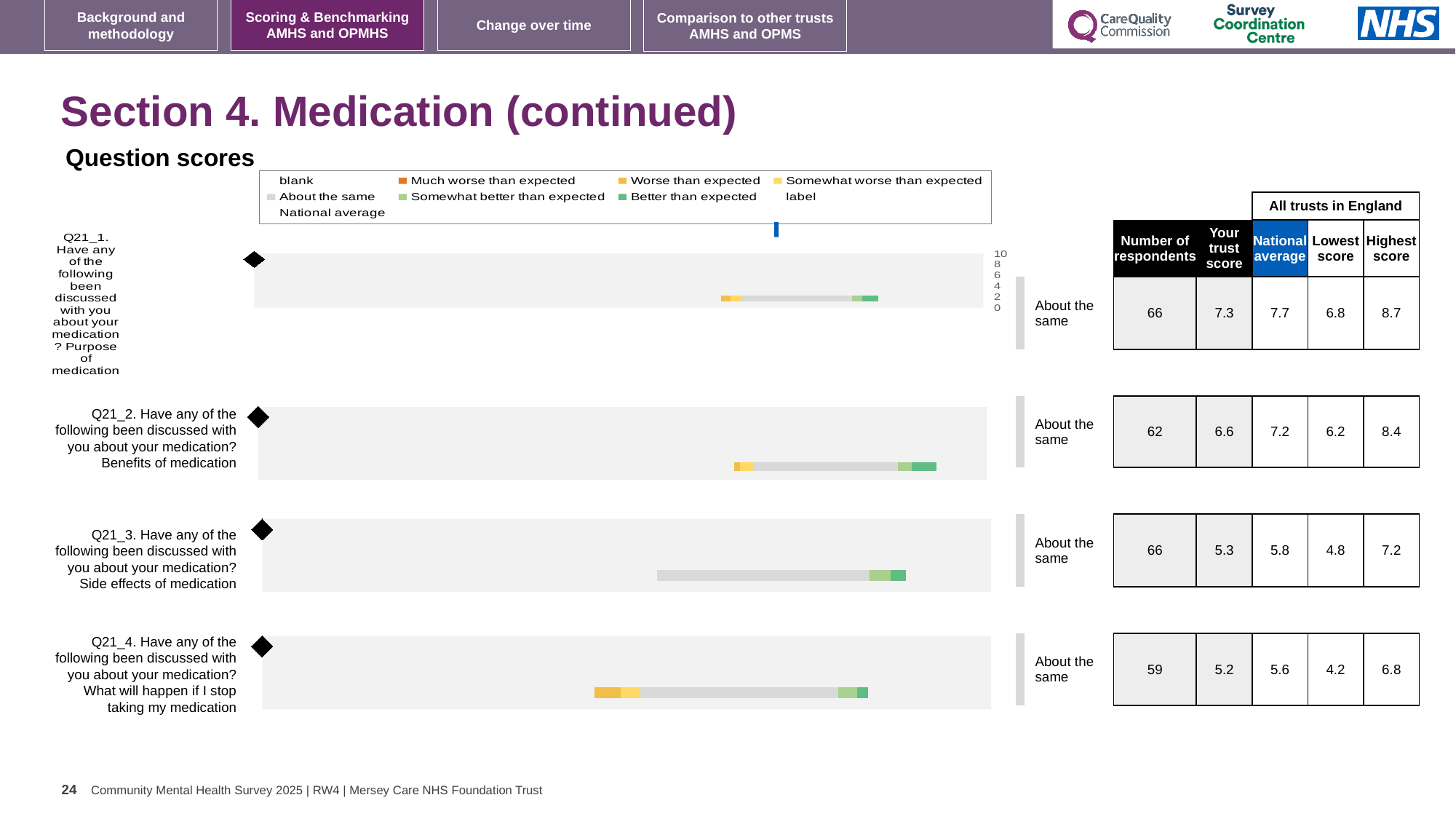
For Q21_1, what is the difference between the highest score and the lowest score across all trusts in England? 1.9 How many question rows (Q21_1 to Q21_4) are plotted on the slide? 4 How many entries does the chart legend list? 9 What is the national average for Q21_3 (Side effects of medication)? 5.8 Which question has the highest 'Your trust score'? Q21_1 (Purpose of medication) What is the 'Your trust score' for Q21_2 (Benefits of medication)? 6.6 How many respondents answered Q21_4 (What will happen if I stop taking my medication)? 59 For Q21_2, which is larger: the trust score or the national average? National average What is the highest score among all trusts in England for Q21_4? 6.8 Which question has the lowest 'Your trust score'? Q21_4 (What will happen if I stop taking my medication) What kind of chart is used to show the question scores on this slide? bar chart What benchmark category is shown for Q21_3 (Side effects of medication)? About the same